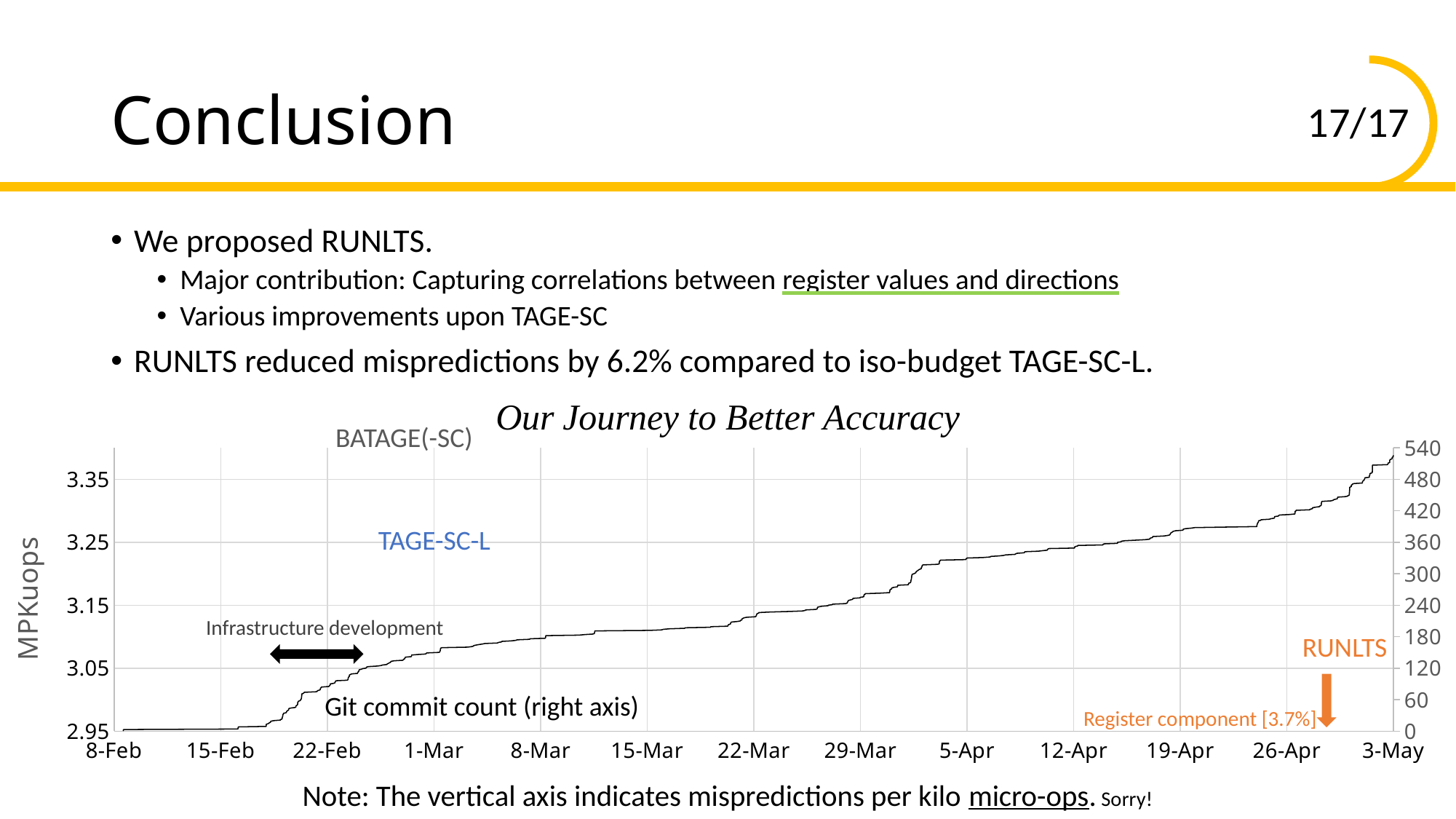
What is the title of the chart on the slide? Our Journey to Better Accuracy Does the Git commit count line rise or fall from 8-Feb to 3-May? rise Is the Git commit count at 1-Mar greater or less than 180? less Is the Git commit count at 3-May greater or less than 480? greater What is the label of the left vertical axis of the chart? MPKuops What kind of chart is shown under the heading "Our Journey to Better Accuracy"? line chart What is the lowest tick value shown on the left-hand axis of the chart? 2.95 How many date labels are shown on the x axis of the chart? 13 Is the Git commit count at 5-Apr greater or less than 300? greater What is the highest tick value shown on the right-hand axis of the chart? 540